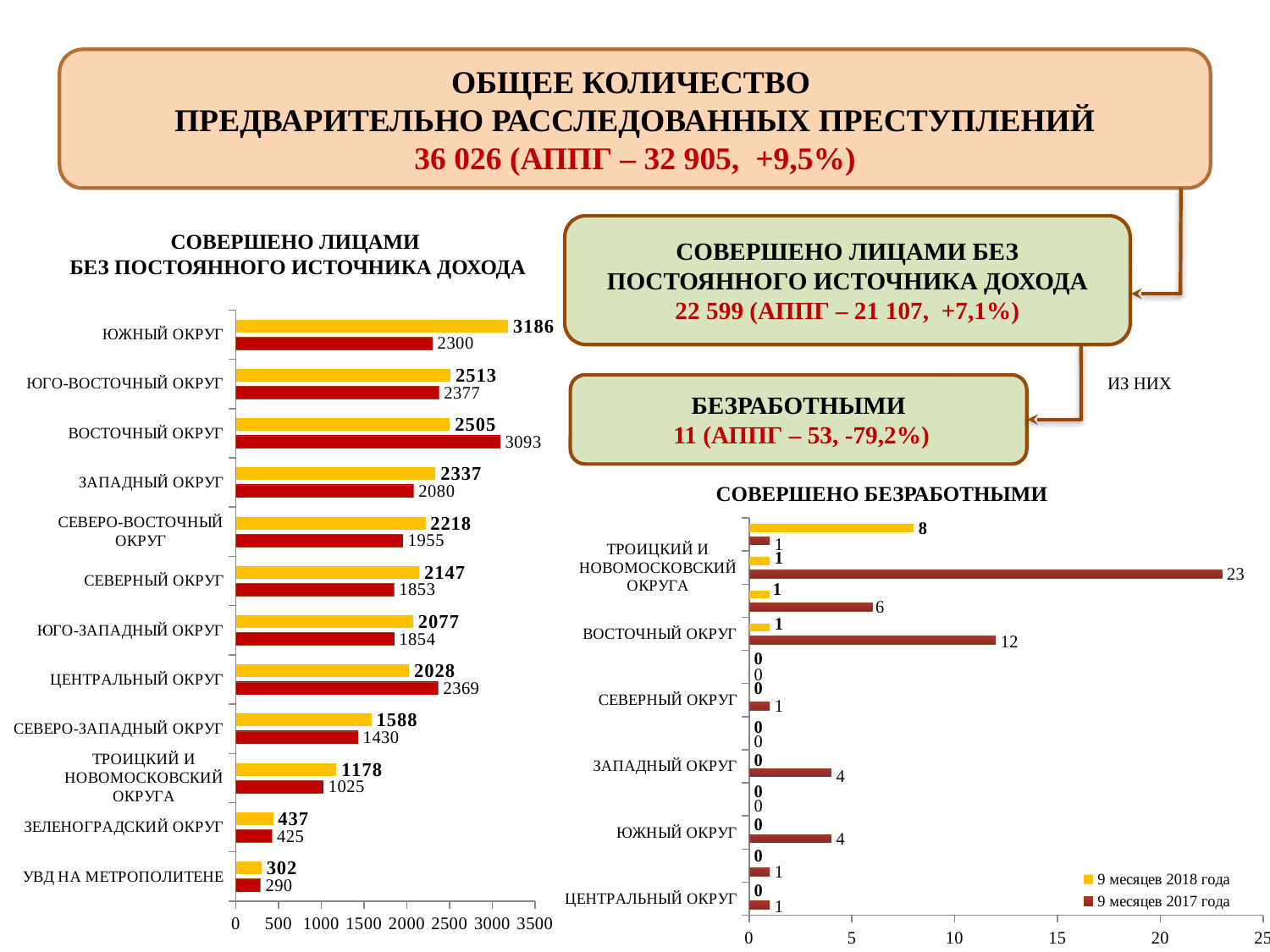
How many series does the legend of the chart 'СОВЕРШЕНО БЕЗРАБОТНЫМИ' list? 2 In the chart 'СОВЕРШЕНО ЛИЦАМИ БЕЗ ПОСТОЯННОГО ИСТОЧНИКА ДОХОДА', what is the 2018 value for ЗЕЛЕНОГРАДСКИЙ ОКРУГ? 437 In the chart 'СОВЕРШЕНО БЕЗРАБОТНЫМИ', what is the highest value on the horizontal axis? 25 In the chart 'СОВЕРШЕНО ЛИЦАМИ БЕЗ ПОСТОЯННОГО ИСТОЧНИКА ДОХОДА', which is larger for ЦЕНТРАЛЬНЫЙ ОКРУГ: the 2018 value or the 2017 value? the 2017 value What type of chart is 'СОВЕРШЕНО БЕЗРАБОТНЫМИ'? bar chart In the chart 'СОВЕРШЕНО ЛИЦАМИ БЕЗ ПОСТОЯННОГО ИСТОЧНИКА ДОХОДА', which category has the lowest 2018 value? УВД НА МЕТРОПОЛИТЕНЕ In the chart 'СОВЕРШЕНО ЛИЦАМИ БЕЗ ПОСТОЯННОГО ИСТОЧНИКА ДОХОДА', how many categories are shown? 12 In the chart 'СОВЕРШЕНО ЛИЦАМИ БЕЗ ПОСТОЯННОГО ИСТОЧНИКА ДОХОДА', what is the value of the yellow (9 месяцев 2018 года) bar for ЮЖНЫЙ ОКРУГ? 3186 In the chart 'СОВЕРШЕНО ЛИЦАМИ БЕЗ ПОСТОЯННОГО ИСТОЧНИКА ДОХОДА', what is the difference between the 2018 and 2017 values for ЮЖНЫЙ ОКРУГ? 886 In the chart 'СОВЕРШЕНО БЕЗРАБОТНЫМИ', what is the largest value shown on any bar? 23 In the chart 'СОВЕРШЕНО ЛИЦАМИ БЕЗ ПОСТОЯННОГО ИСТОЧНИКА ДОХОДА', which category has the highest 2017 (red) value? ВОСТОЧНЫЙ ОКРУГ In the chart 'СОВЕРШЕНО ЛИЦАМИ БЕЗ ПОСТОЯННОГО ИСТОЧНИКА ДОХОДА', what is the value of the red (9 месяцев 2017 года) bar for ВОСТОЧНЫЙ ОКРУГ? 3093